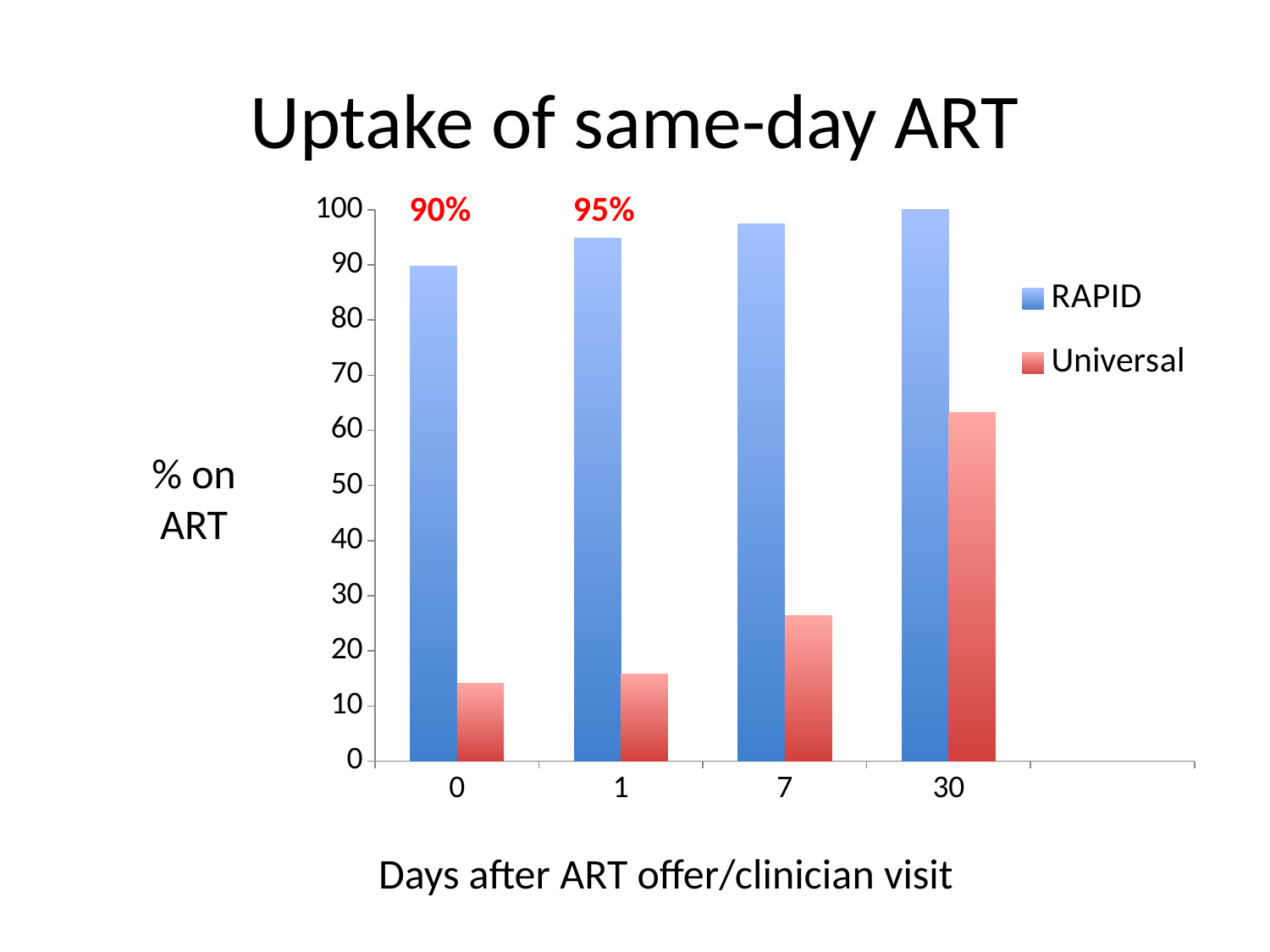
What is the value for RAPID at 1 day after ART offer/clinician visit? 95% At which number of days is the RAPID value lowest? 0 What is the difference between the RAPID values at day 1 and day 0? 5% How many day categories are shown on the x axis? 4 What is the value for RAPID at 0 days after ART offer/clinician visit? 90% How many series does the legend list? 2 Is the value for Universal at day 7 greater or less than 20? greater Is the value for Universal at day 30 greater or less than 60? greater At which number of days is the Universal value highest? 30 Do the Universal values rise or fall as the number of days increases? rise Is the value for Universal at day 0 greater or less than 20? less At day 30, which series has the larger value, RAPID or Universal? RAPID